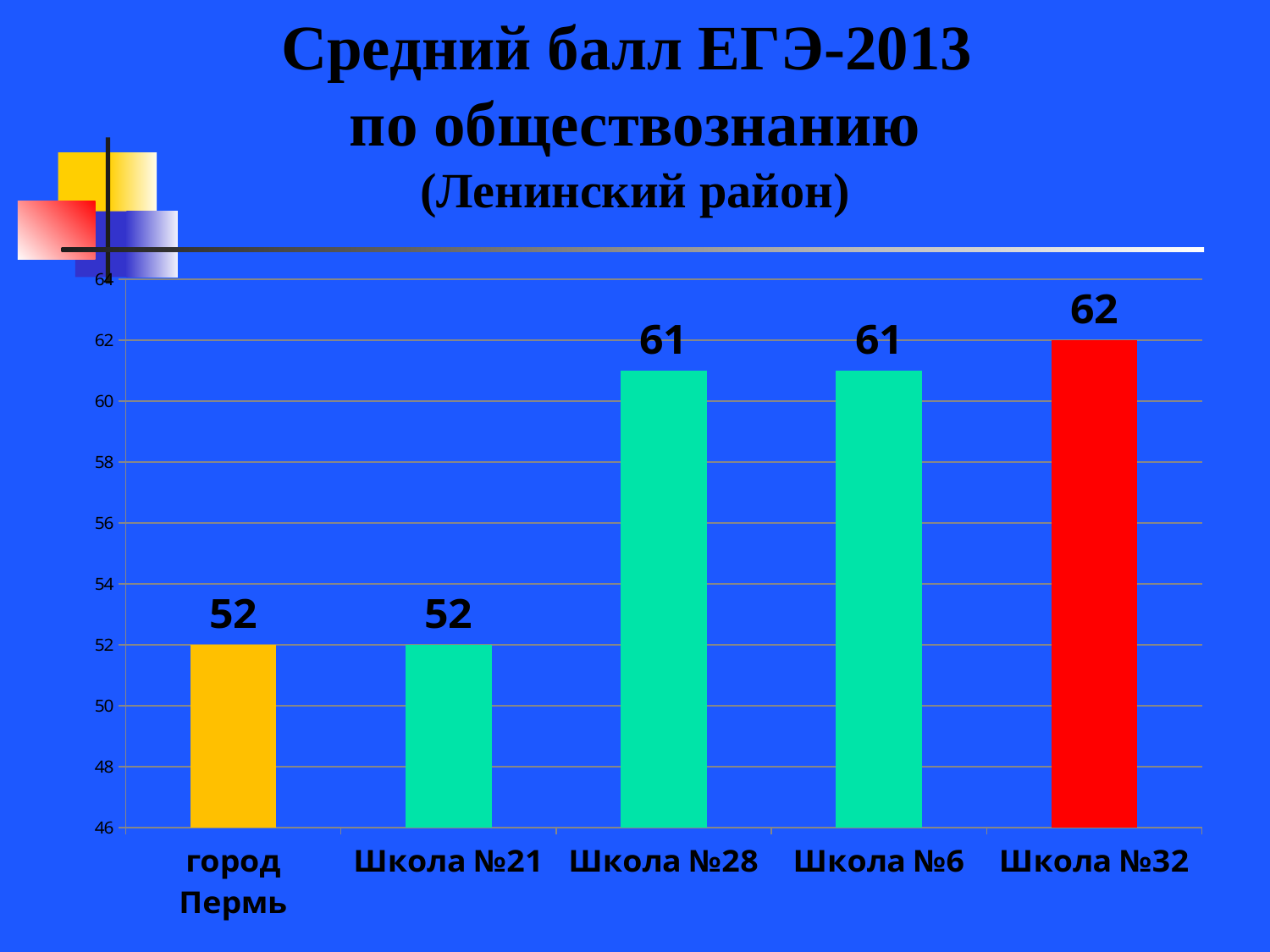
What is the difference between the values for Школа №32 and Школа №21? 10 What is the title of the chart on the slide? Средний балл ЕГЭ-2013 по обществознанию (Ленинский район) What is the difference between the values for Школа №6 and город Пермь? 9 What colour is the bar for Школа №32? red What is the value for город Пермь? 52 Which is larger, the value for Школа №28 or the value for Школа №21? Школа №28 What is the value for Школа №28? 61 Is the value for Школа №6 greater or less than 56? greater What kind of chart is shown on the slide? bar chart How many categories are shown on the x axis? 5 Which category has the highest value? Школа №32 What is the value for Школа №32? 62